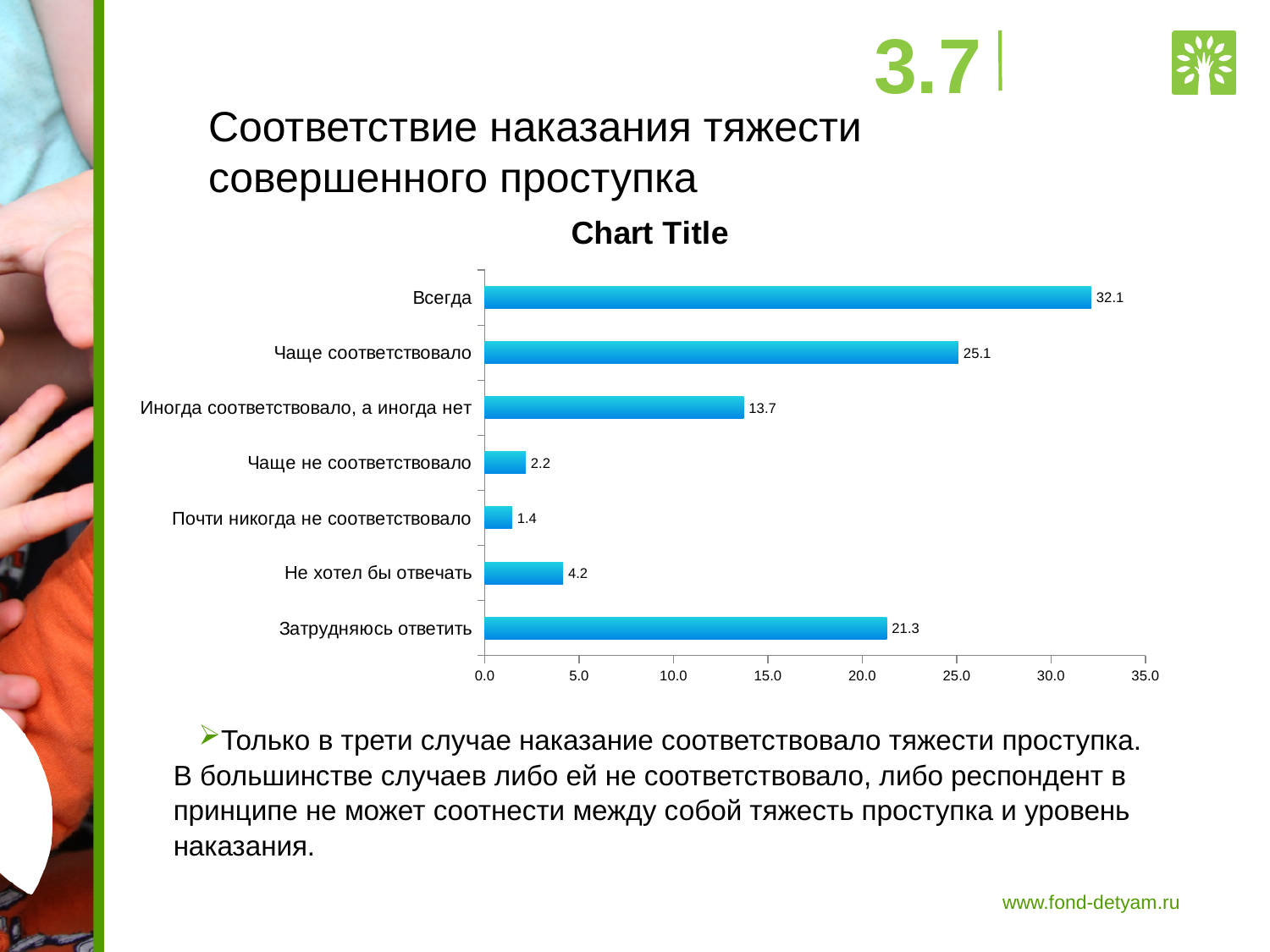
Which is larger: the value for "Иногда соответствовало, а иногда нет" or the value for "Затрудняюсь ответить"? Затрудняюсь ответить Which category has the highest value? Всегда Is the value for "Чаще соответствовало" greater or less than 20.0? greater How many categories are shown in the chart? 7 What is the title shown above the chart? Chart Title What is the value for "Чаще не соответствовало"? 2.2 What is the difference between the values for "Всегда" and "Чаще соответствовало"? 7.0 What is the maximum value shown on the horizontal axis? 35.0 Which category has the lowest value? Почти никогда не соответствовало What is the value for "Всегда"? 32.1 What kind of chart is shown on the slide? bar chart What is the value for "Затрудняюсь ответить"? 21.3